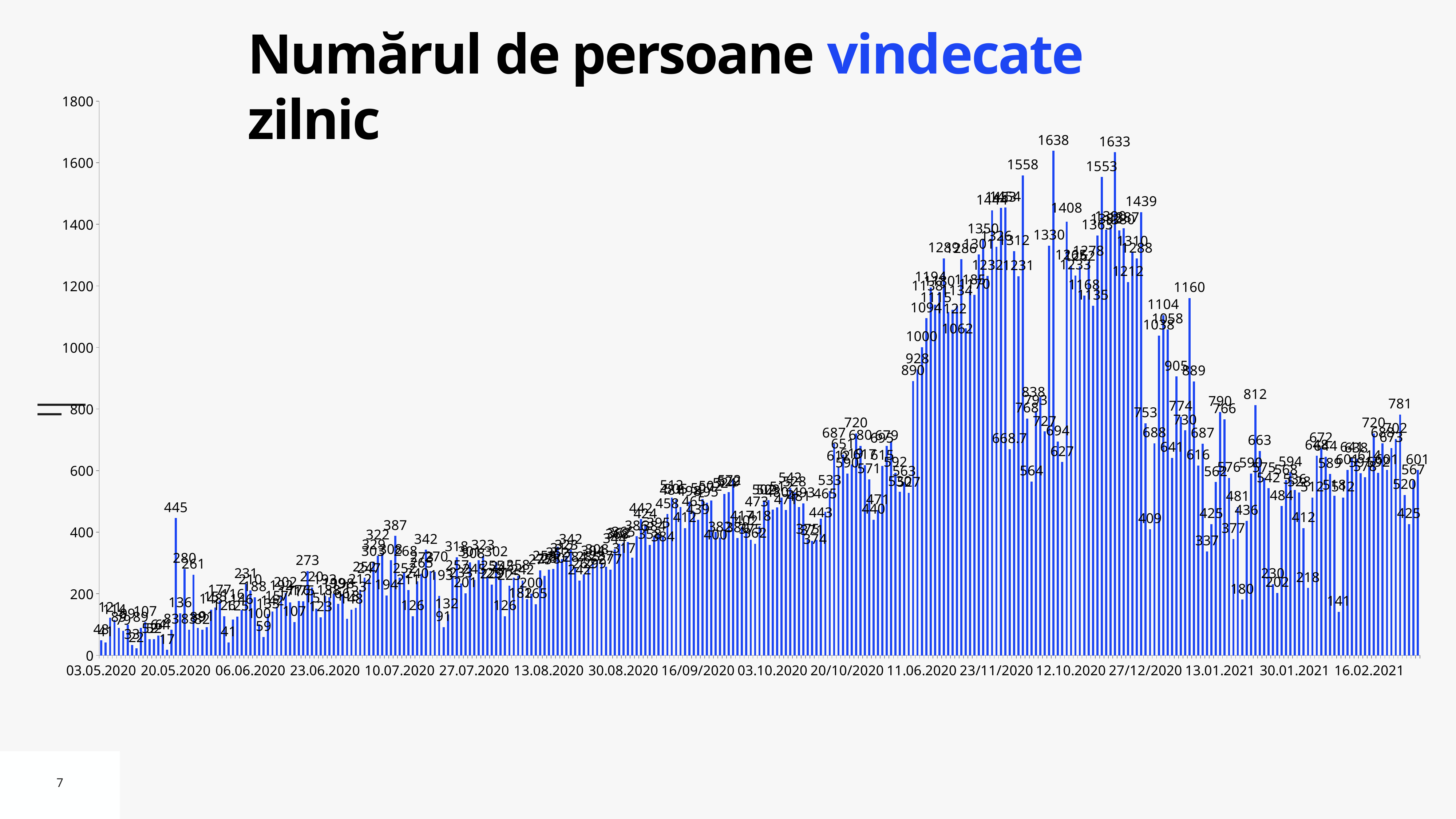
Is the bar labelled 445 near 20.05.2020 greater or less than 400? greater What is the highest daily value shown on the chart? 1638 Do the values generally rise or fall from May 2020 to November 2020? rise Is the tallest bar on the chart greater or less than 1600? greater Which is larger, the bar labelled 445 in May 2020 or the bar labelled 387 in July 2020? 445 What is the difference between the two highest labelled values, 1638 and 1633? 5 What is the lowest value labelled on the chart? 17 Which is larger, the bar labelled 1160 or the bar labelled 812? 1160 What kind of chart is shown on the slide? bar chart What is the difference between the highest value, 1638, and the bar labelled 1558? 80 What is the title of the chart? Numărul de persoane vindecate zilnic What is the second-highest value labelled on the chart? 1633